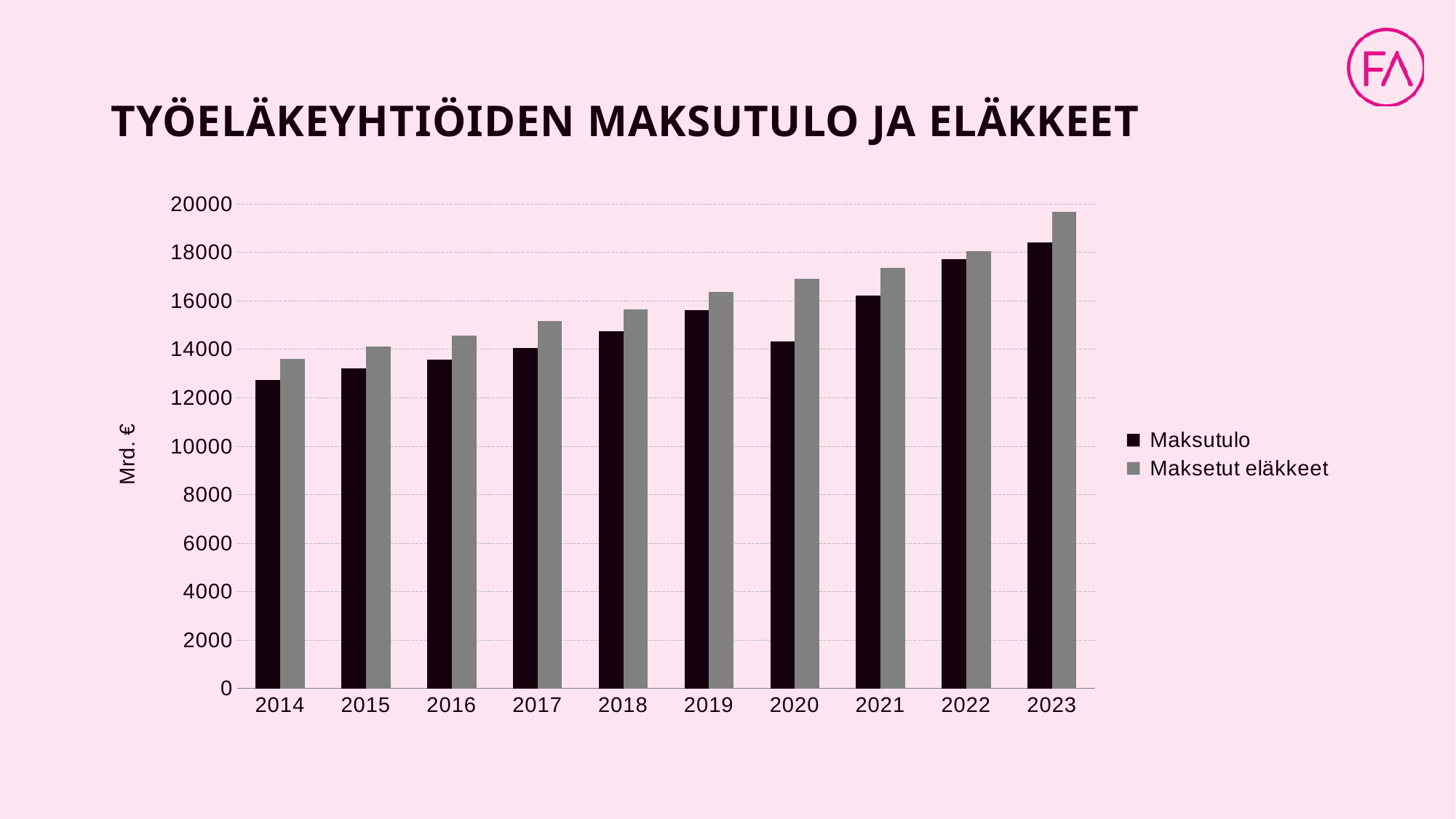
How many years are shown on the x axis? 10 Is the Maksutulo value for 2023 greater or less than 18000? greater In which year is Maksetut eläkkeet highest? 2023 Is the Maksutulo value for 2014 greater or less than 12000? greater In which year is Maksutulo lowest? 2014 How many series does the legend list? 2 Is the Maksetut eläkkeet value for 2020 greater or less than 16000? greater In 2023, which is larger: Maksutulo or Maksetut eläkkeet? Maksetut eläkkeet Do the Maksetut eläkkeet values rise or fall from 2014 to 2023? rise What kind of chart is shown on the slide? bar chart